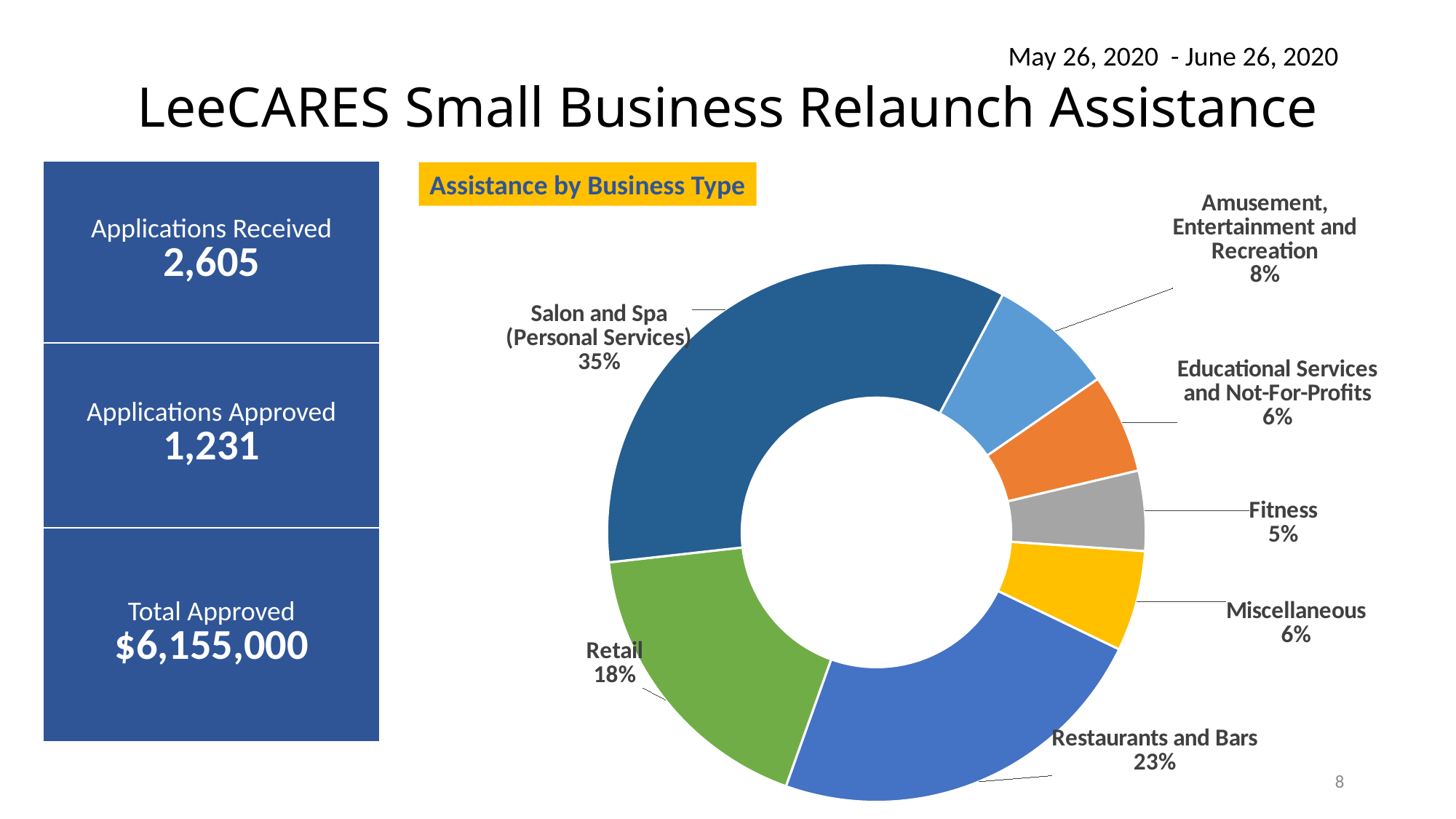
What share of assistance went to Fitness? 5% What share of assistance went to Salon and Spa (Personal Services)? 35% What share of assistance went to Retail? 18% Which business type received the largest share of assistance? Salon and Spa (Personal Services) What is the title of the chart? Assistance by Business Type What kind of chart is used to show Assistance by Business Type? Doughnut (pie) chart Which received a larger share of assistance, Retail or Restaurants and Bars? Restaurants and Bars What share of assistance went to Restaurants and Bars? 23% What share of assistance went to Amusement, Entertainment and Recreation? 8% What is the difference in percentage points between the Salon and Spa (Personal Services) share and the Restaurants and Bars share? 12 How many business type categories are shown in the chart? 7 Which business type received the smallest share of assistance? Fitness